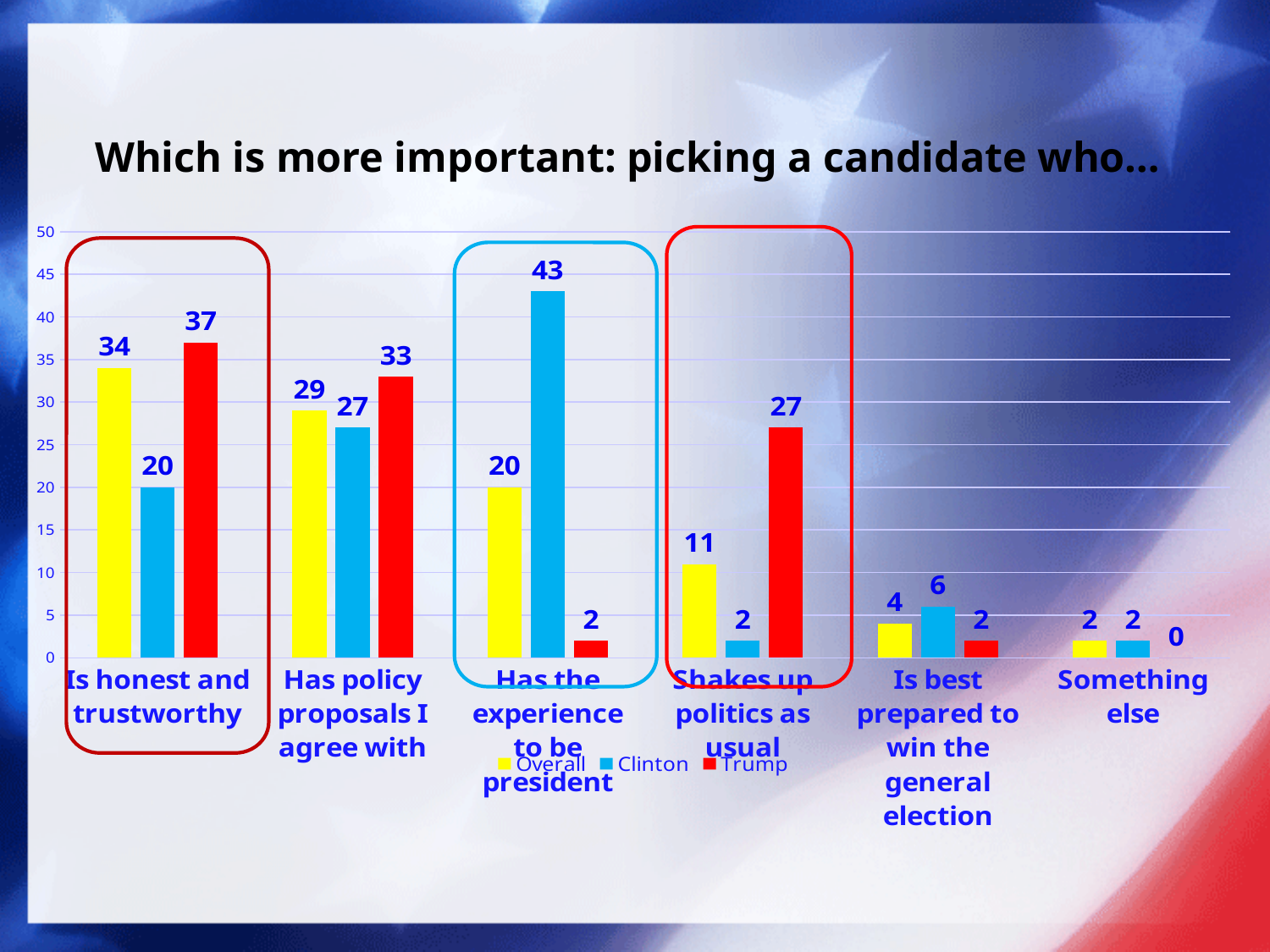
What is the Overall value for "Is honest and trustworthy"? 34 Which category has the highest Trump value? Is honest and trustworthy Which is larger for "Has policy proposals I agree with": the Overall value or the Clinton value? Overall What is the Clinton value for "Has the experience to be president"? 43 What is the difference between the Trump and Clinton values for "Is honest and trustworthy"? 17 How many series does the legend list? 3 What is the title of the chart? Which is more important: picking a candidate who... Which colour represents the Clinton series in the legend? Blue What is the Trump value for "Shakes up politics as usual"? 27 How many categories are shown on the x axis? 6 Which category has the lowest Clinton value? Shakes up politics as usual and Something else (both 2) What kind of chart is shown on the slide? Bar chart